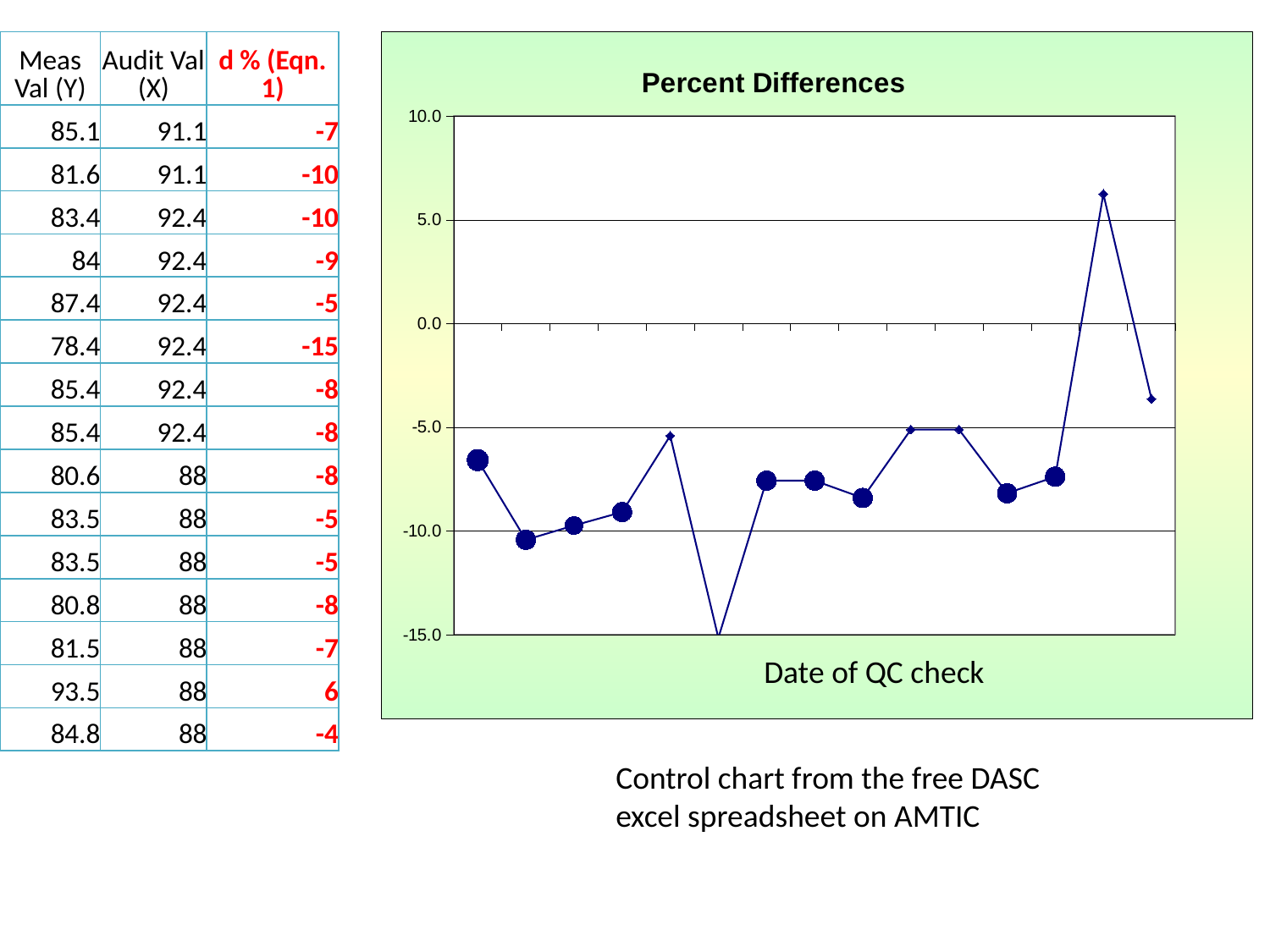
Is the highest point on the chart greater or less than 5.0? greater How many data points are plotted on the line in the chart? 15 Which data point on the chart has the lowest value? the 6th point What is the title of the chart? Percent Differences What is the label on the x axis of the chart? Date of QC check How many data points on the chart lie above 0.0? 1 Is the lowest point on the chart greater or less than -10.0? less Is the first data point on the chart greater or less than -5.0? less Does the line rise or fall between the 13th and 14th data points? rise Which data point on the chart has the highest value? the 14th point (second to last) What kind of chart is shown on the slide? line chart